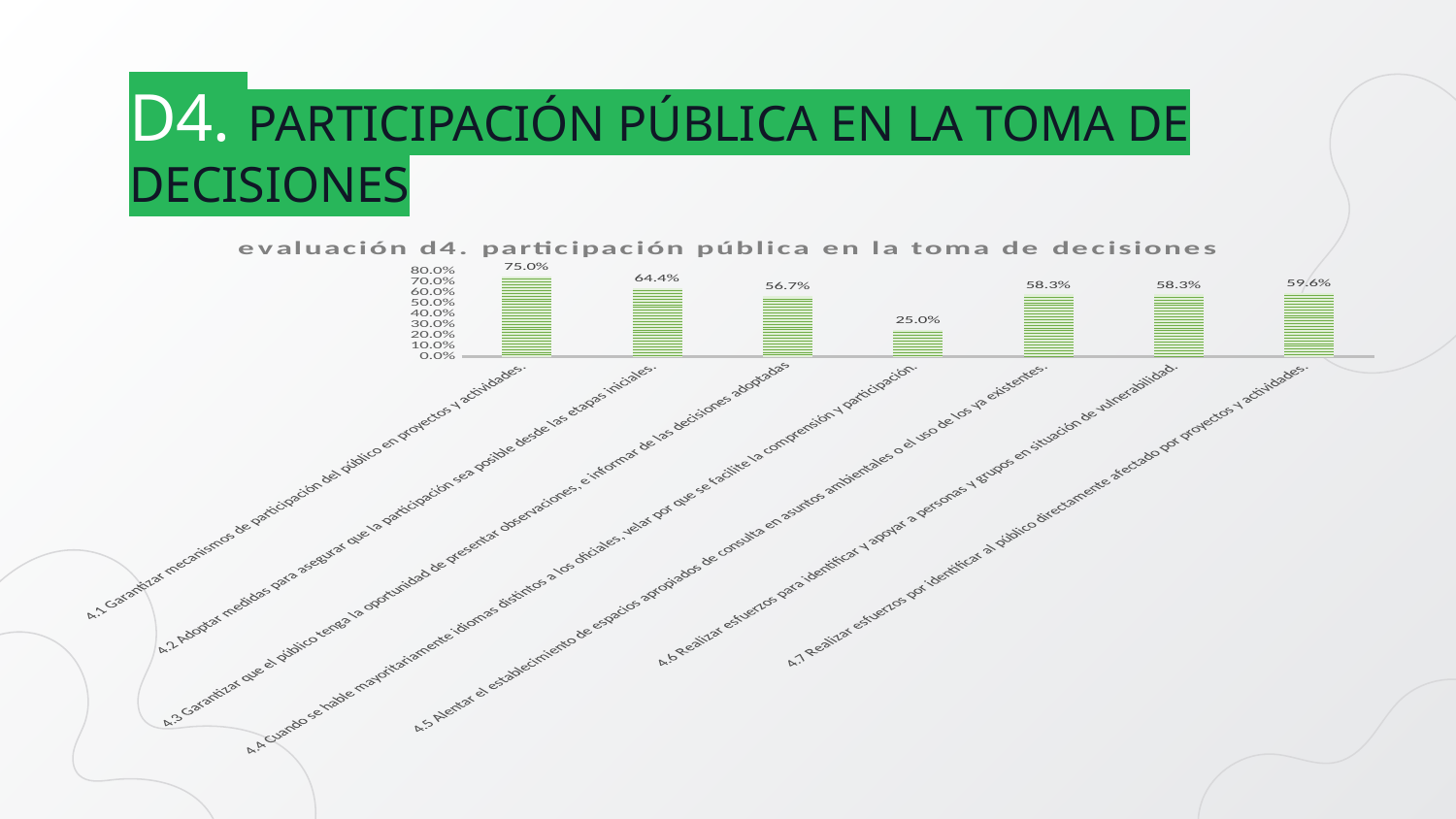
How many categories (bars) does the chart show? 7 What is the title of the chart? evaluación d4. participación pública en la toma de decisiones Which category has the lowest value? 4.4 Cuando se hable mayoritariamente idiomas distintos a los oficiales, velar por que se facilite la comprensión y participación Is the value for category 4.3 greater or less than 50.0%? greater What is the value for category 4.4 (Cuando se hable mayoritariamente idiomas distintos a los oficiales...)? 25.0% What is the value for category 4.7 (Realizar esfuerzos por identificar al público directamente afectado por proyectos y actividades)? 59.6% What is the value for category 4.1 (Garantizar mecanismos de participación del público en proyectos y actividades)? 75.0% What is the value for category 4.2 (Adoptar medidas para asegurar que la participación sea posible desde las etapas iniciales)? 64.4% What is the difference between the values for category 4.1 and category 4.4? 50.0% Which is larger, the value for category 4.2 or the value for category 4.3? 4.2 Which category has the highest value? 4.1 Garantizar mecanismos de participación del público en proyectos y actividades What type of chart is shown on the slide? bar chart